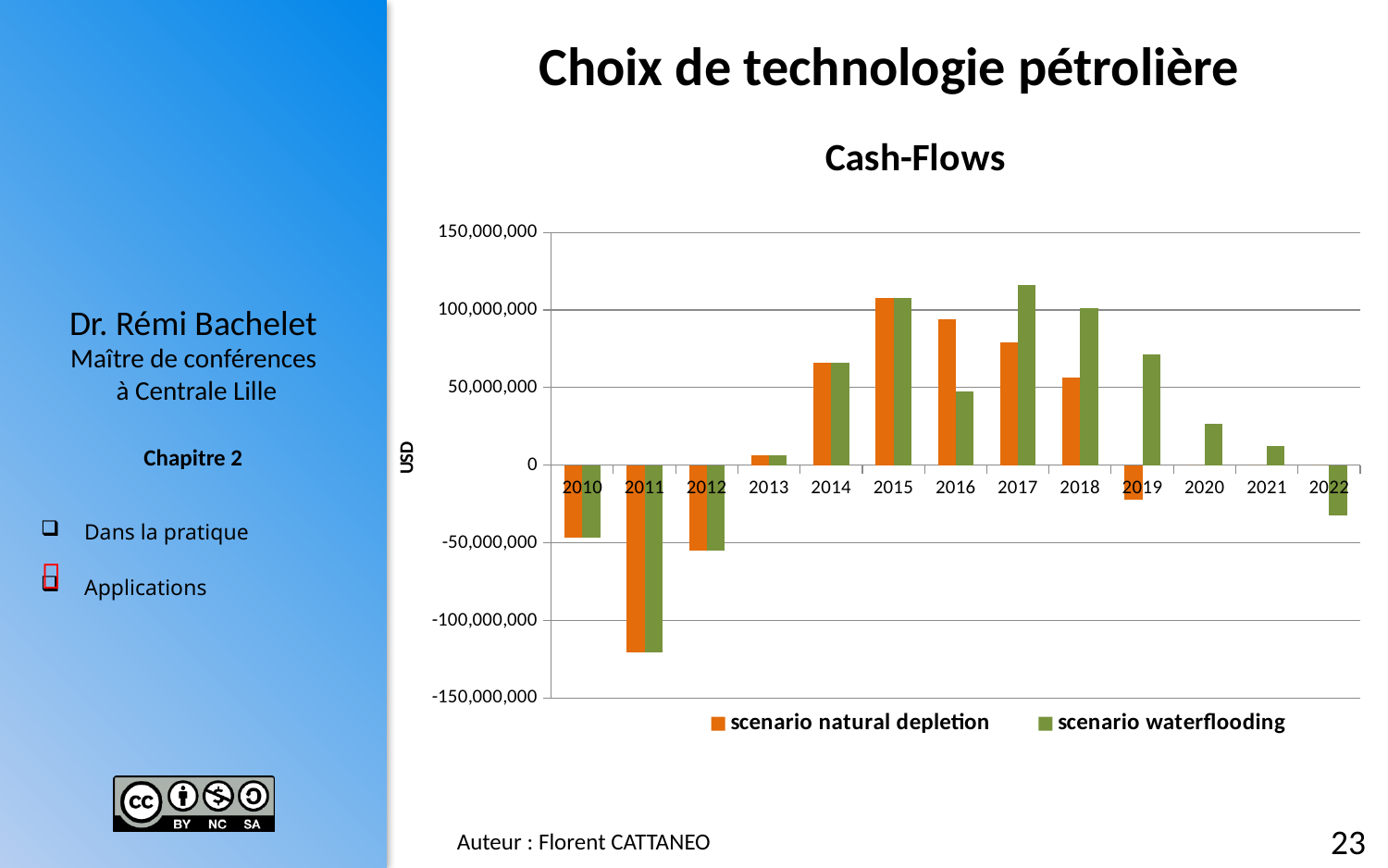
Is the scenario natural depletion value for 2014 greater or less than 50,000,000? greater How many series does the legend of the Cash-Flows chart list? 2 What is the label of the vertical axis of the Cash-Flows chart? USD In which year is the scenario natural depletion cash flow lowest? 2011 In 2018, which scenario has the larger cash flow, natural depletion or waterflooding? scenario waterflooding How many years are shown on the x axis of the Cash-Flows chart? 13 In 2016, which scenario has the larger cash flow, natural depletion or waterflooding? scenario natural depletion What kind of chart is shown on the slide? bar chart In which year is the scenario natural depletion cash flow highest? 2015 Is the scenario natural depletion value for 2011 greater or less than -100,000,000? less In which year is the scenario waterflooding cash flow highest? 2017 Is the scenario waterflooding value for 2017 greater or less than 100,000,000? greater